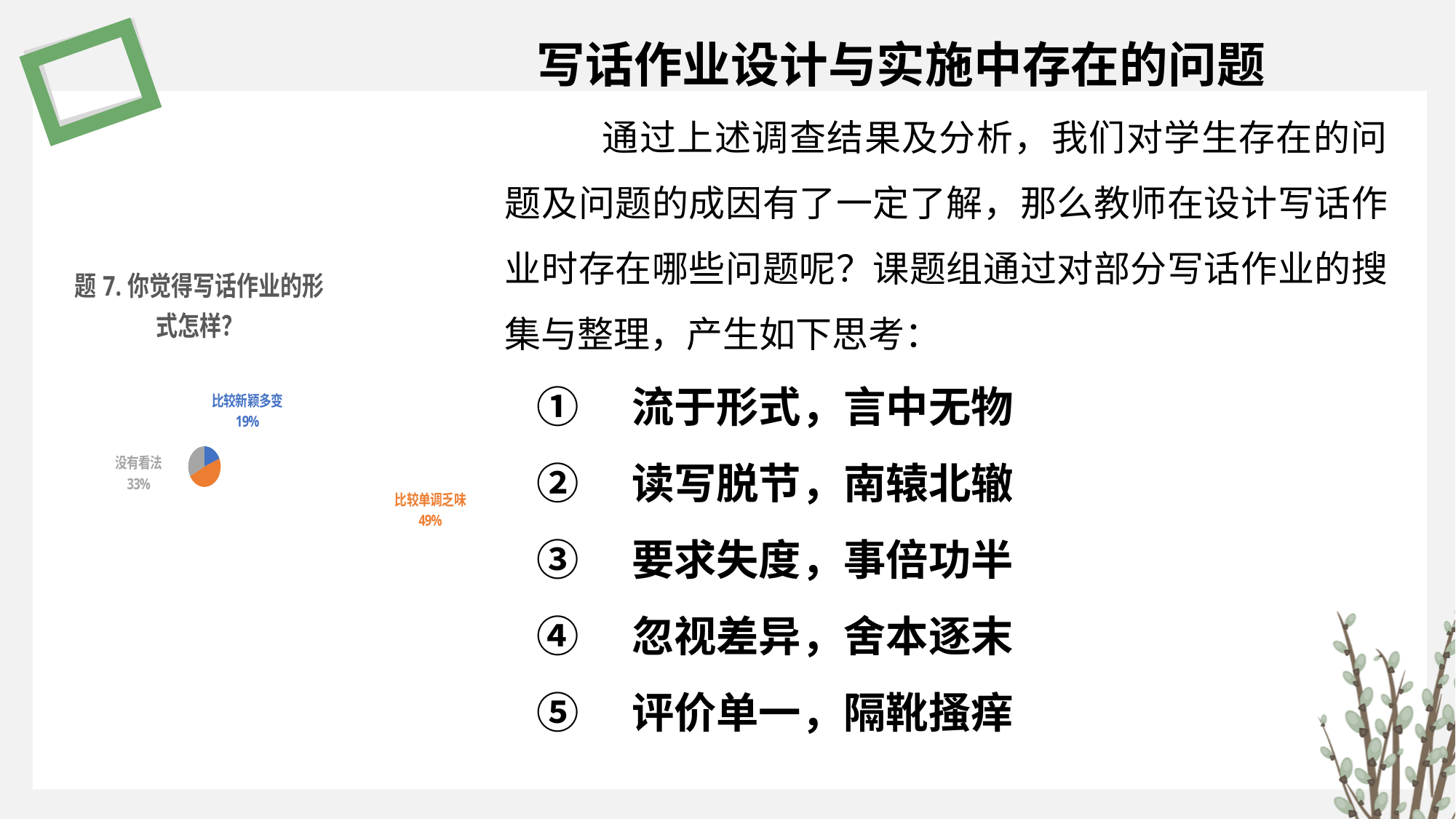
Which slice of the pie chart is the smallest? 比较新颖多变 What percentage of the pie is labelled 比较新颖多变? 19% How many slices does the pie chart have? 3 Which is larger, the share for 没有看法 or the share for 比较新颖多变? 没有看法 What kind of chart is shown on the slide? pie chart What is the difference in percentage points between 比较单调乏味 and 没有看法? 16 What percentage of the pie is labelled 比较单调乏味? 49% Which slice of the pie chart is the largest? 比较单调乏味 What is the title of the chart on the slide? 题 7. 你觉得写话作业的形式怎样? What is the difference in percentage points between 比较单调乏味 and 比较新颖多变? 30 What percentage of the pie is labelled 没有看法? 33% What colour is the slice for 比较单调乏味 in the pie chart? orange